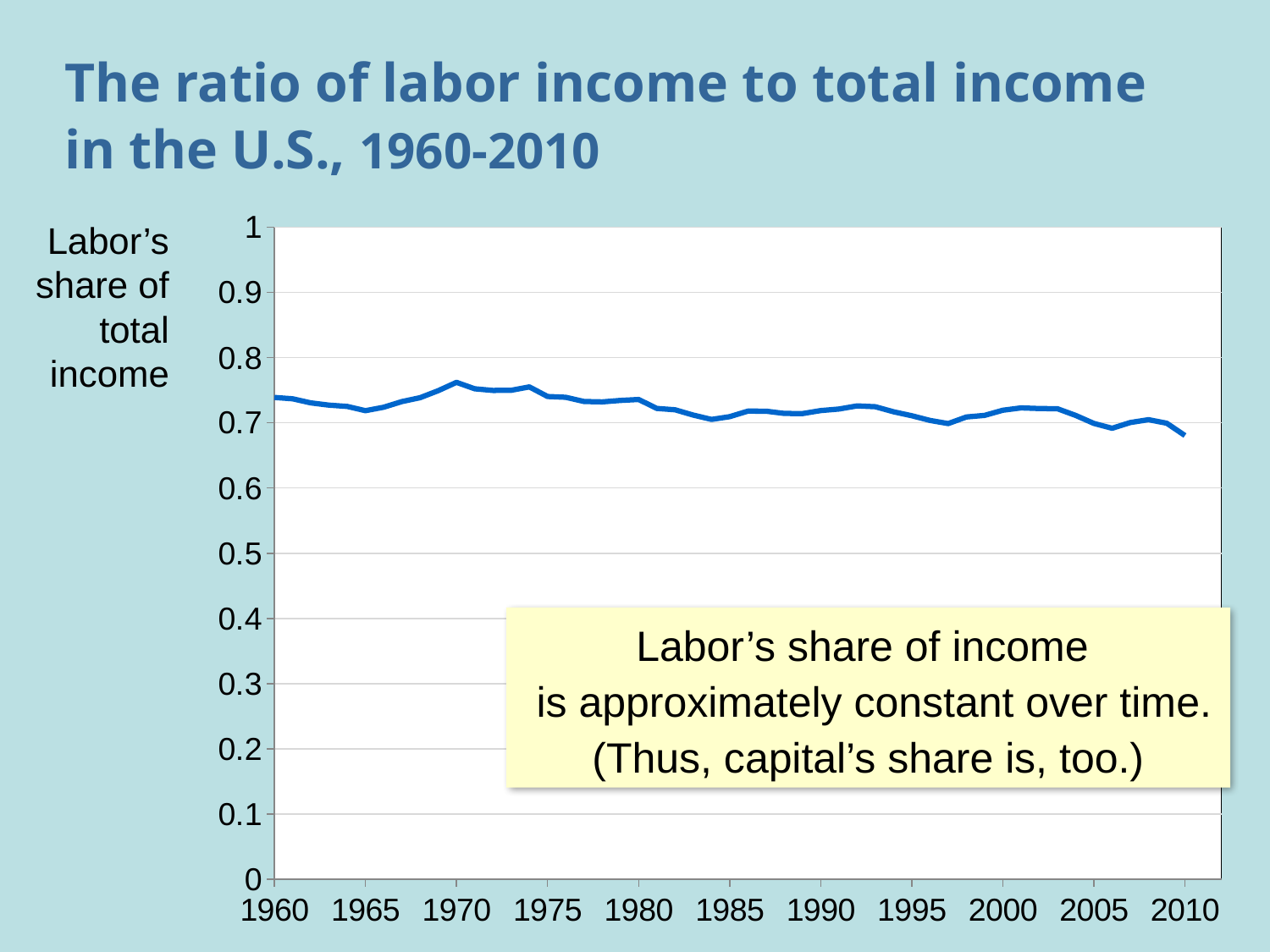
Does the line rise or fall between 1965 and 1970? rises Is the value for 1970 greater or less than 0.7? greater Around which year labelled on the x axis does the line reach its highest point? 1970 Is the value for 1985 greater or less than 0.6? greater What is the title of the chart? The ratio of labor income to total income in the U.S., 1960-2010 Is the value for 1960 greater or less than 0.8? less Does the line rise or fall between 1970 and 1985? falls How many year labels are shown on the x axis? 11 What does the vertical axis of the chart measure? Labor's share of total income What kind of chart is shown on the slide? line chart